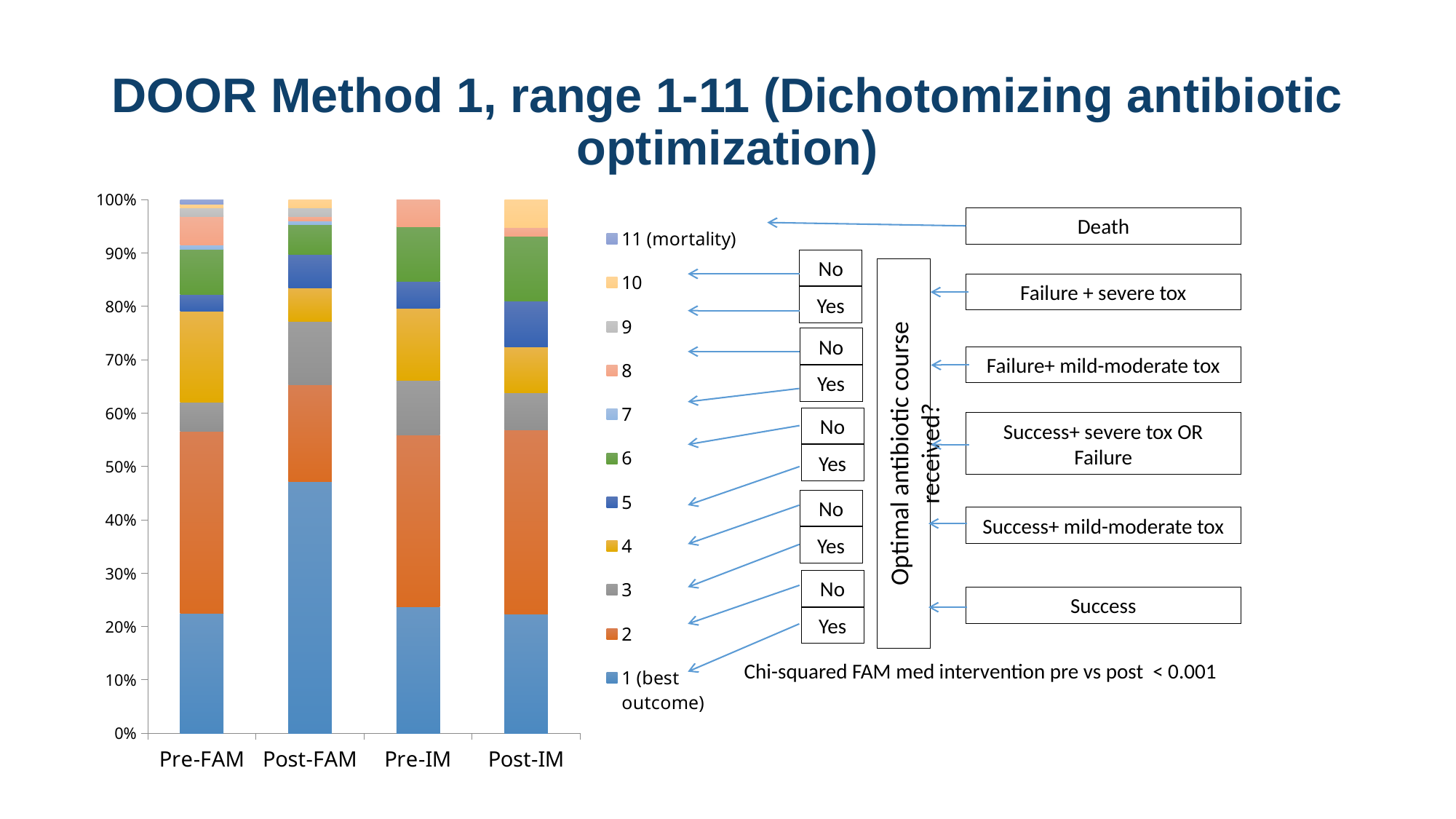
Which is larger: the share of series 4 in Pre-FAM or in Post-FAM? Pre-FAM Which category has the largest share for series 10? Post-IM Which category has the largest share for series 1 (best outcome)? Post-FAM What is the legend label for the series plotted at the bottom of each bar? 1 (best outcome) What is the total height of each stacked bar in the chart? 100% Is the share of series 1 (best outcome) in the Pre-FAM bar greater or less than 30%? less Is the share of series 1 (best outcome) in the Post-FAM bar greater or less than 40%? greater Which is larger: the share of series 1 (best outcome) in Pre-FAM or in Post-FAM? Post-FAM Which category has the smallest share for series 2? Post-FAM How many series does the chart's legend list? 11 How many categories are shown on the x axis of the chart? 4 What kind of chart is shown on the slide? Stacked bar chart